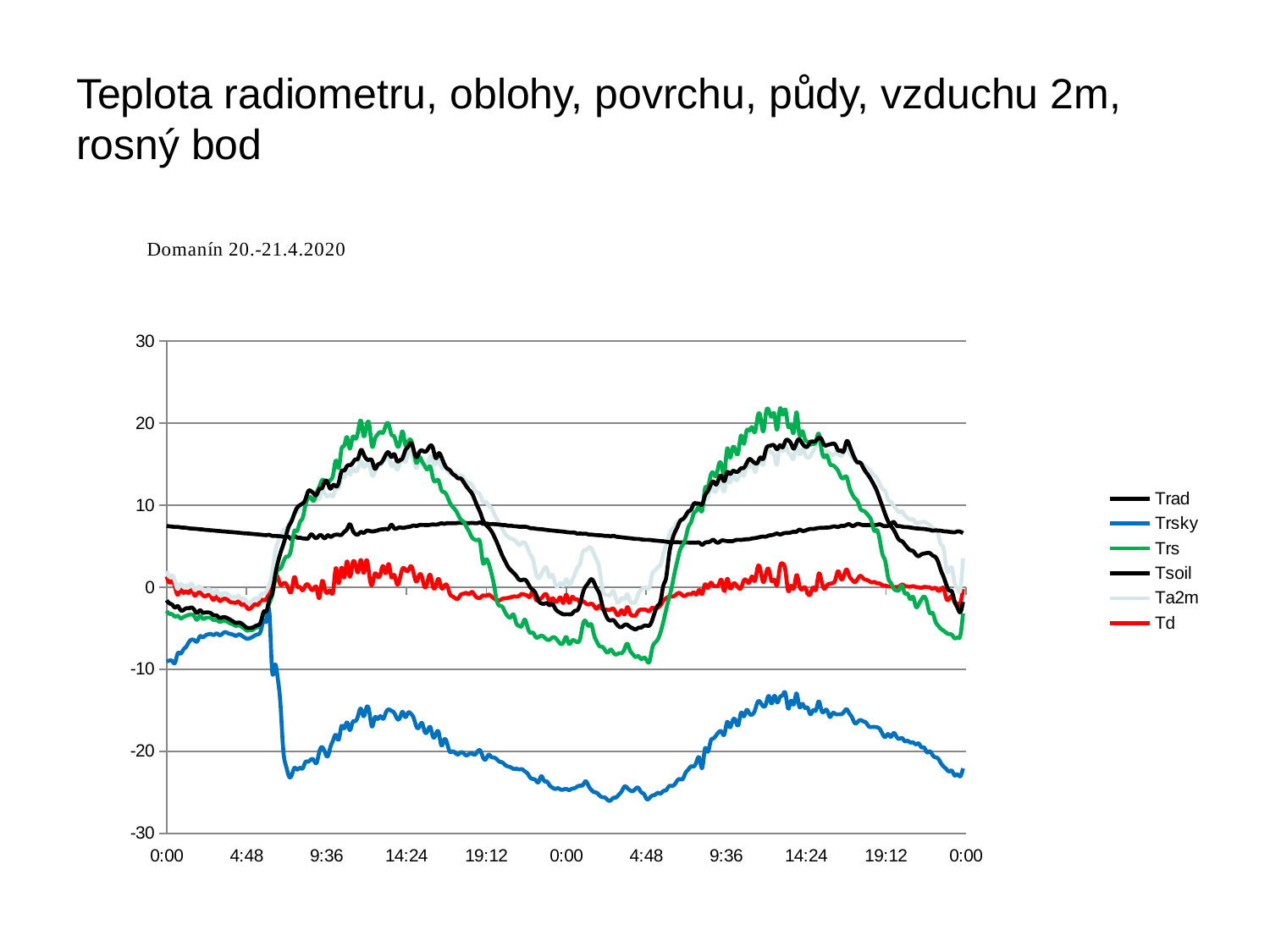
Does Trs rise or fall between 4:48 and 9:36 on the first day? rise Which series has the lowest values throughout the chart? Trsky Is the peak value of Trs on the second day greater or less than 10? greater Which series is plotted in red? Td Is the value of Tsoil at the first 0:00 greater or less than 0? greater What is the highest value shown on the y axis? 30 How many series does the legend list? 6 Does Trs rise or fall between 14:24 and 19:12 on the second day? fall Which series is plotted in blue? Trsky What kind of chart is shown on the slide? line chart Is the lowest value of Trsky greater or less than -20? less